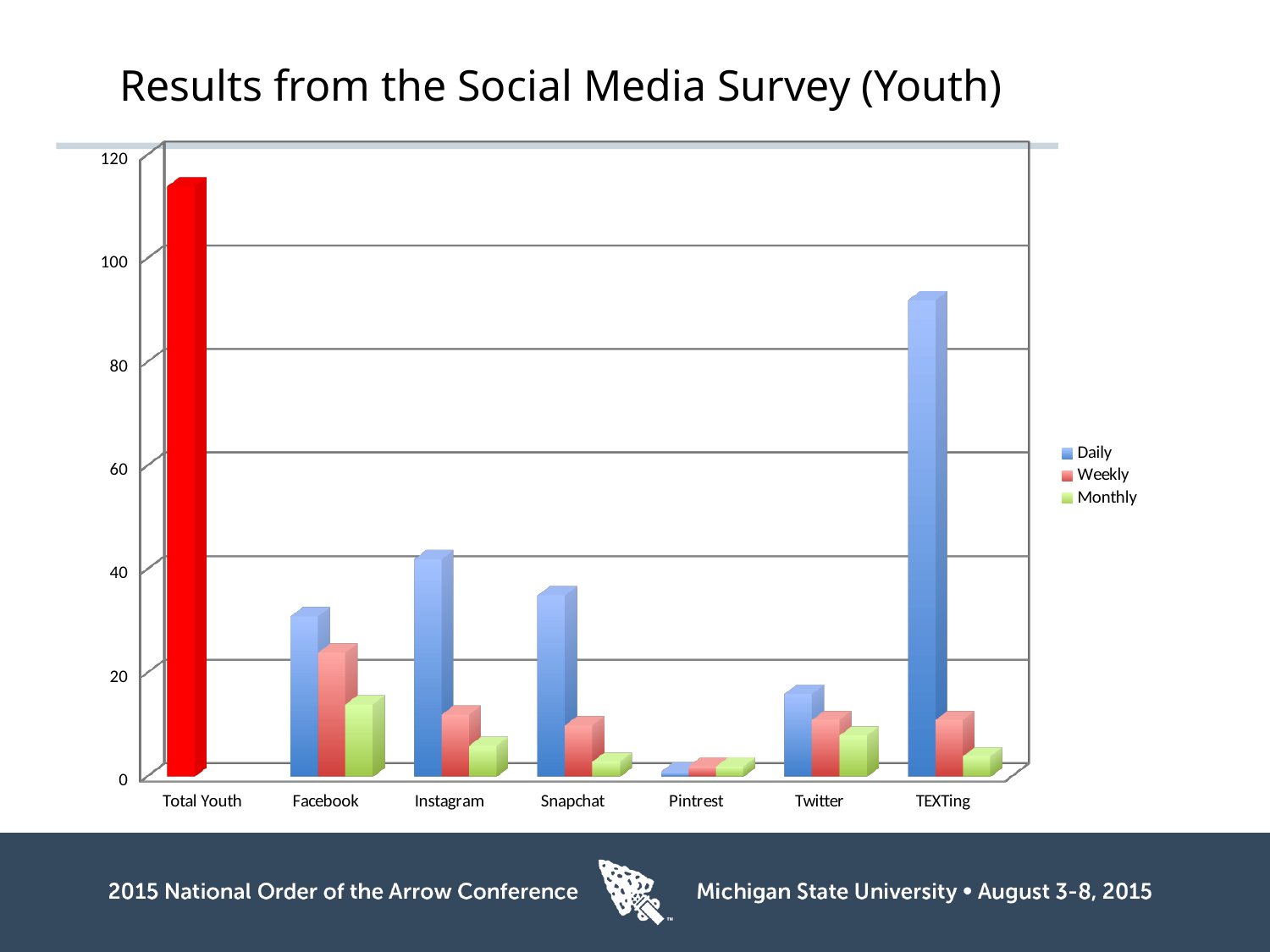
Which category has the shortest Daily bar? Pintrest Is the Daily value for Twitter greater or less than 20? less Is the Daily value for Facebook greater or less than 20? greater Is the Daily value for TEXTing greater or less than 80? greater How many categories are shown along the x axis? 7 What is the title of the slide containing the chart? Results from the Social Media Survey (Youth) Which is larger, the Monthly value for Facebook or the Monthly value for Instagram? Facebook How many series does the legend list? 3 Which is larger, the Daily value for Instagram or the Daily value for Snapchat? Instagram What kind of chart is shown on the slide? bar chart